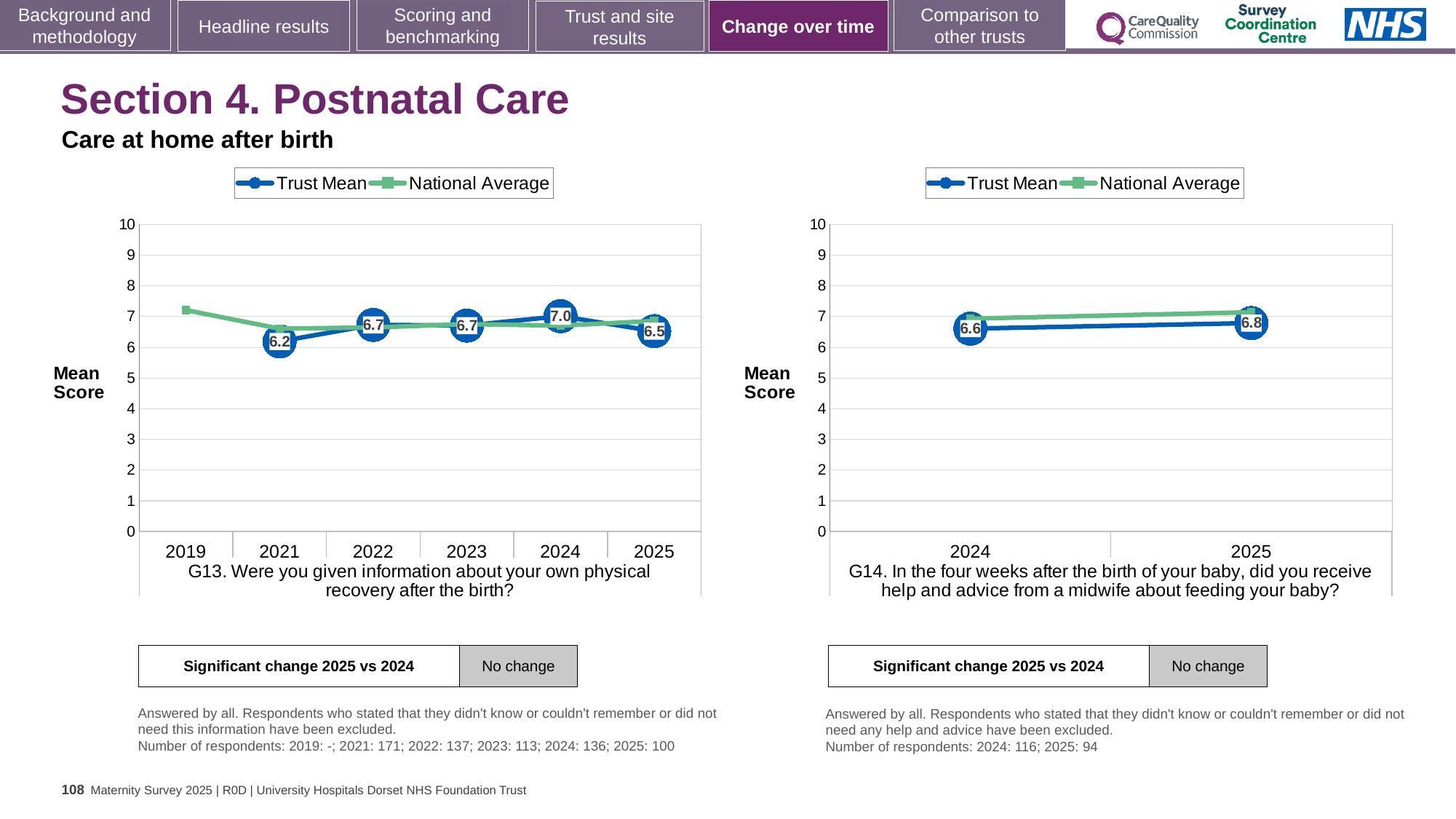
In the left chart (G13), is the National Average value for 2019 greater or less than 7? greater How many years are shown on the x axis of the left chart (G13)? 6 How many series does the legend of the right chart (G14) list? 2 In the left chart (G13), which year has the lowest Trust Mean score? 2021 In the right chart (G14), what is the Trust Mean score for 2025? 6.8 In the left chart (G13), what is the Trust Mean score for 2021? 6.2 In the right chart (G14), what is the difference between the Trust Mean scores for 2025 and 2024? 0.2 In the left chart (G13), which year has the highest Trust Mean score? 2024 In the left chart (G13), what is the Trust Mean score for 2024? 7.0 In the left chart (G13), what is the difference between the Trust Mean scores for 2024 and 2025? 0.5 In the left chart (G13), is the Trust Mean score higher in 2021 or in 2022? 2022 In the right chart (G14), does the Trust Mean rise or fall from 2024 to 2025? rise